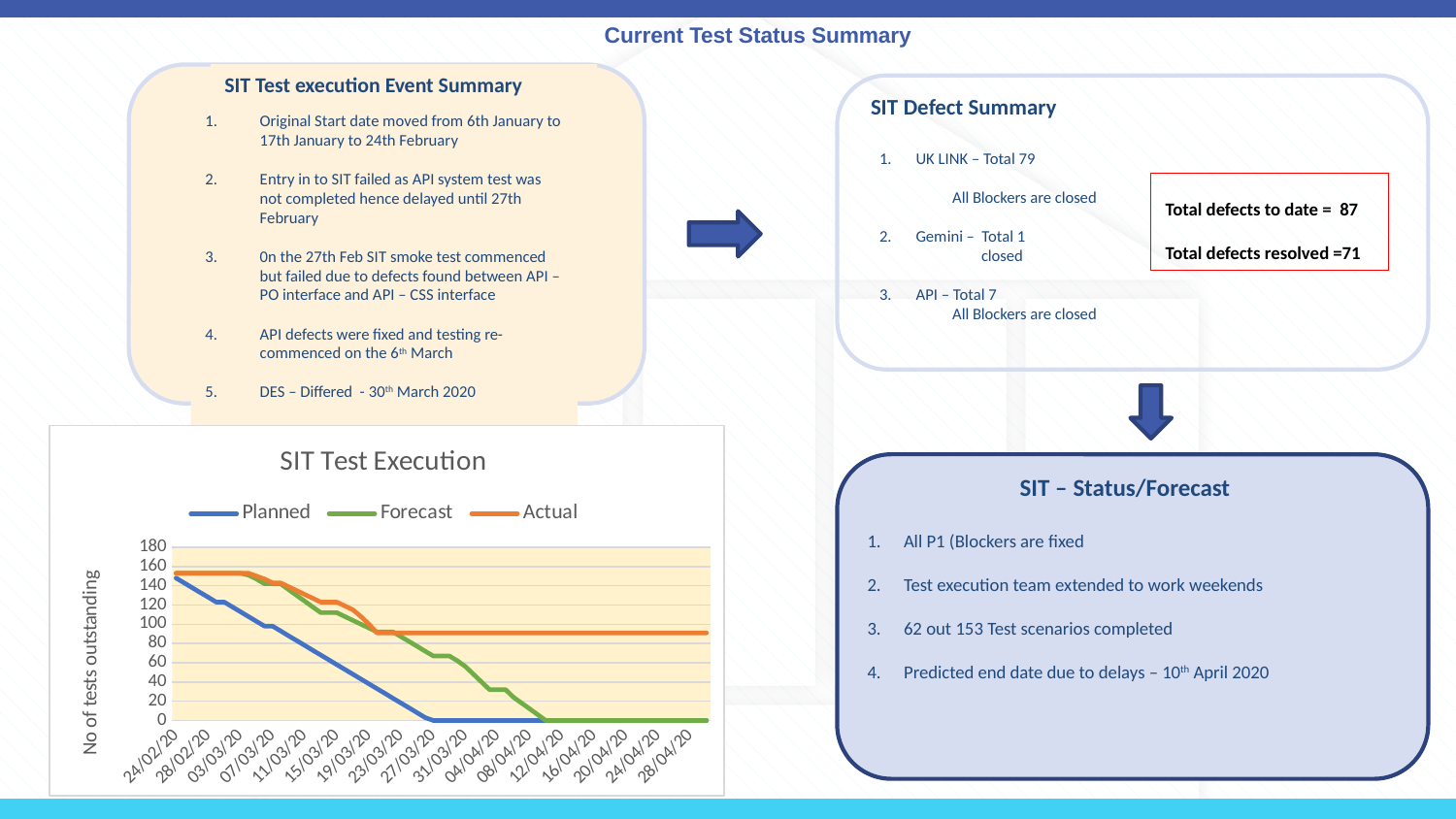
What is the Forecast value at 28/04/20 in the SIT Test Execution chart? 0 What are the series names shown in the legend of the SIT Test Execution chart? Planned, Forecast, Actual In the SIT Test Execution chart, is the Actual value at 28/04/20 greater or less than 80? greater In the SIT Test Execution chart, at 11/03/20 which is higher, Forecast or Planned? Forecast What kind of chart is the SIT Test Execution chart? line chart In the SIT Test Execution chart, which series has the highest value at 28/04/20? Actual How many series does the legend of the SIT Test Execution chart list? 3 Does the Planned series in the SIT Test Execution chart rise or fall along the x axis? fall What is the Planned value at 28/04/20 in the SIT Test Execution chart? 0 What is the y-axis title of the SIT Test Execution chart? No of tests outstanding In the SIT Test Execution chart, is the Actual value at 28/04/20 greater or less than 100? less In the SIT Test Execution chart, is the Planned value at 24/02/20 greater or less than 140? greater